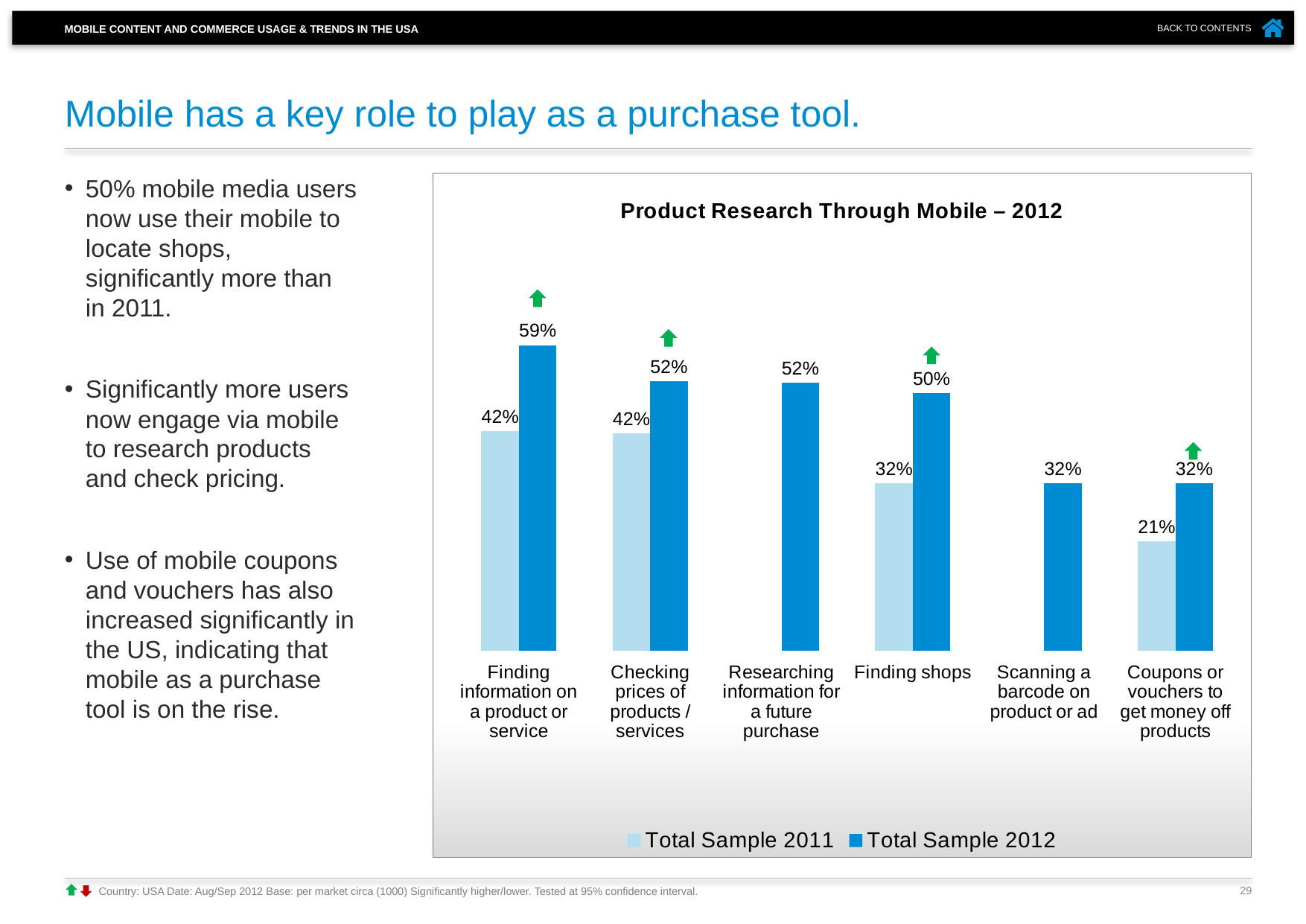
How many categories are shown on the x axis? 6 Which category has the lowest Total Sample 2011 value? Coupons or vouchers to get money off products What is the difference between the Total Sample 2012 and Total Sample 2011 values for Finding information on a product or service? 17% What is the difference between the Total Sample 2012 and Total Sample 2011 values for Finding shops? 18% Which is larger: the Total Sample 2012 value for Checking prices of products / services or the Total Sample 2012 value for Finding shops? Checking prices of products / services What is the Total Sample 2011 value for Coupons or vouchers to get money off products? 21% What is the Total Sample 2012 value for Finding information on a product or service? 59% What kind of chart is shown on the slide? Bar chart How many series does the legend list? 2 What is the Total Sample 2012 value for Finding shops? 50% What is the title of the chart? Product Research Through Mobile – 2012 Which category has the highest Total Sample 2012 value? Finding information on a product or service